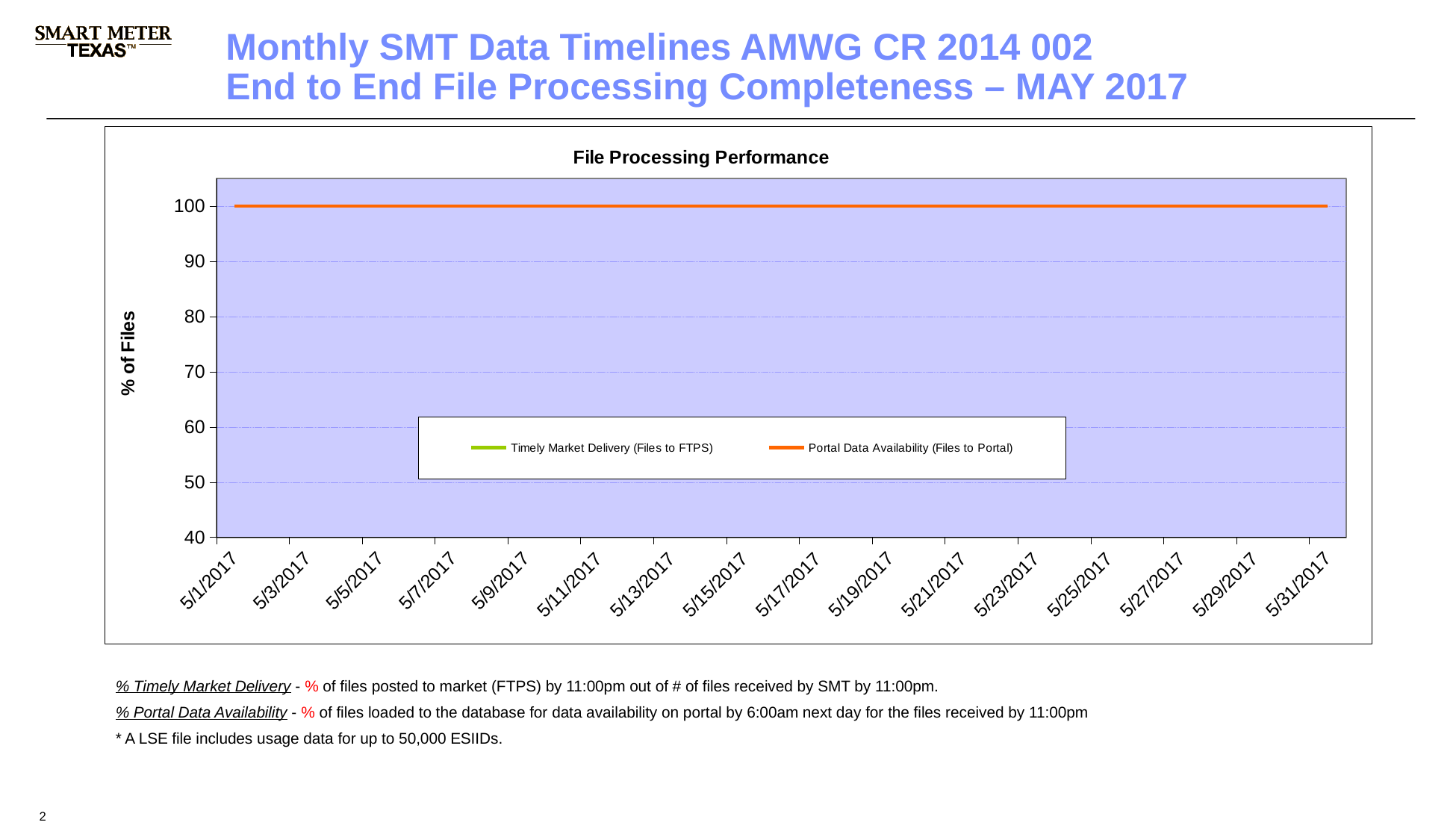
How many series does the chart legend list? 2 What is the lowest value shown on the y axis? 40 What is the label of the y axis? % of Files What kind of chart is shown on the slide? line chart Is the value for Portal Data Availability (Files to Portal) on 5/21/2017 greater or less than 90? greater What is the value of Portal Data Availability (Files to Portal) on 5/15/2017? 100 What is the value of Portal Data Availability (Files to Portal) on 5/31/2017? 100 What is the title of the chart? File Processing Performance How many date labels are shown on the x axis? 16 What is the value of Portal Data Availability (Files to Portal) on 5/1/2017? 100 Do the plotted values rise, fall, or stay flat from 5/1/2017 to 5/31/2017? stay flat